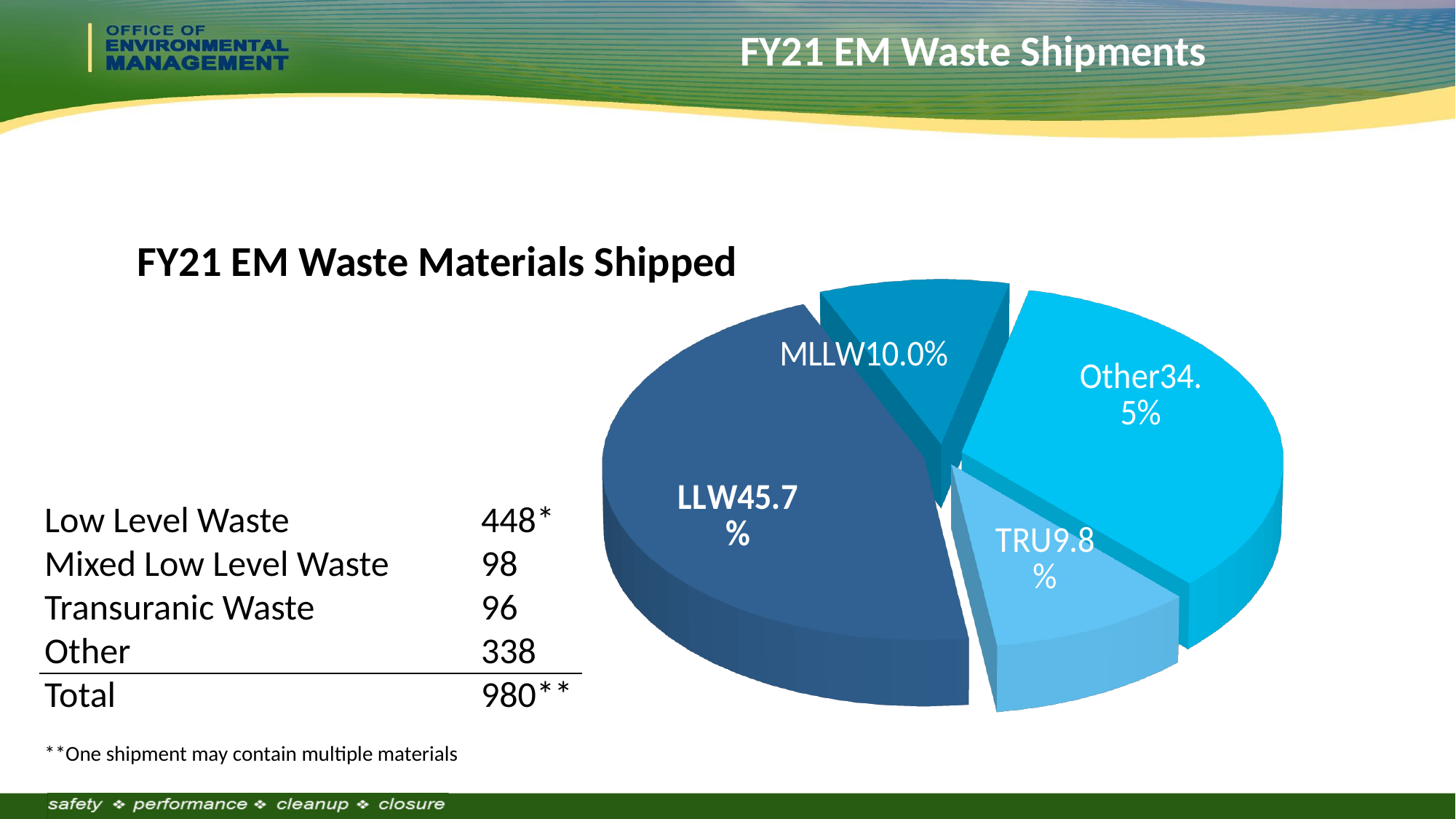
What is the difference in percentage points between the MLLW slice and the TRU slice? 0.2 What percentage is shown for TRU? 9.8% Which is larger, the LLW slice or the Other slice? LLW What is the title of the chart? FY21 EM Waste Materials Shipped What share of the pie does LLW represent? 45.7% How many slices does the pie chart have? 4 What percentage is shown for MLLW? 10.0% Which slice of the pie chart is the largest? LLW Which slice of the pie chart is the smallest? TRU What share of the pie does Other represent? 34.5% What is the difference in percentage points between the LLW slice and the Other slice? 11.2 What type of chart is shown on the slide? Pie chart